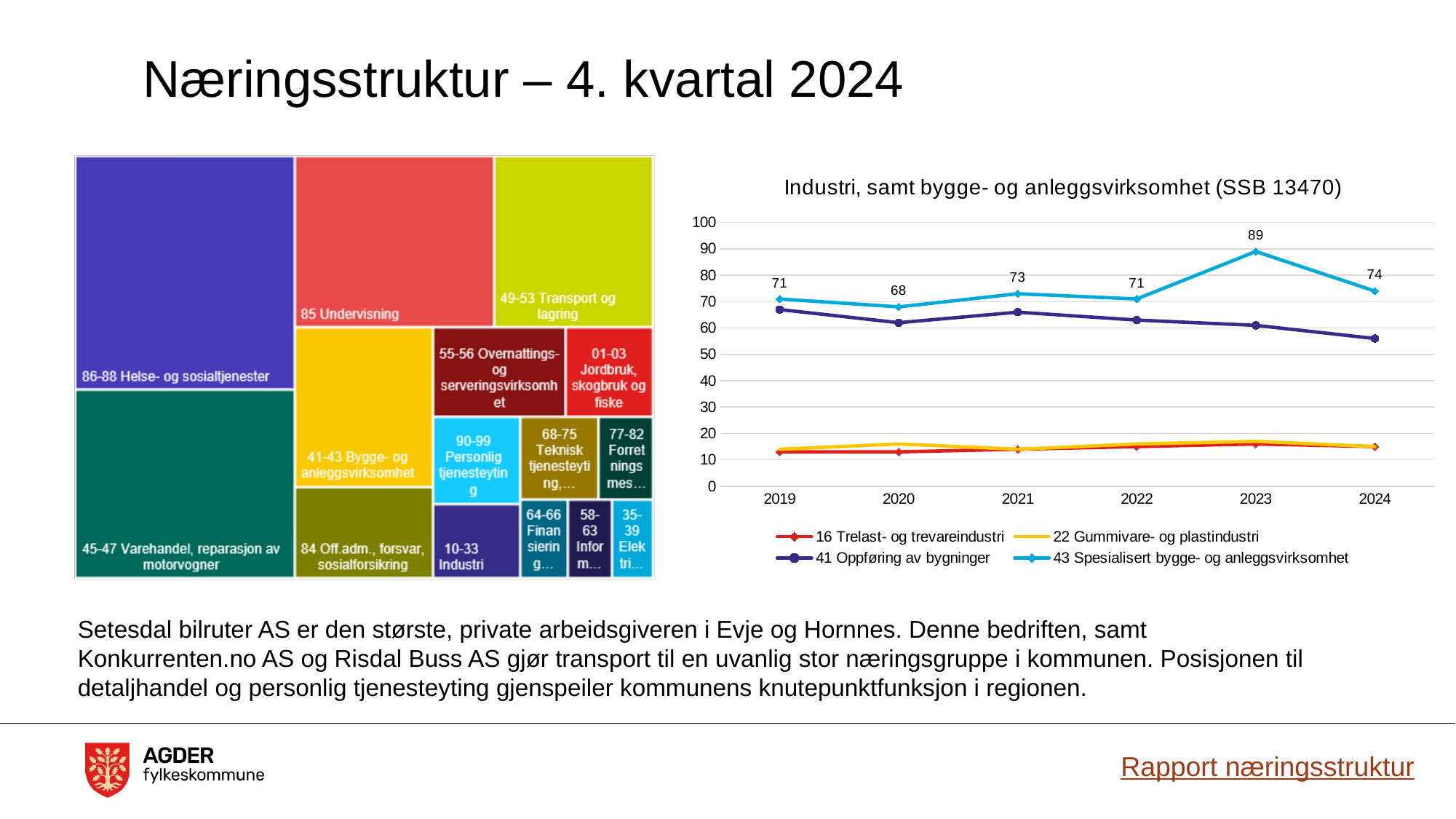
In the chart titled 'Industri, samt bygge- og anleggsvirksomhet (SSB 13470)', in which year is 43 Spesialisert bygge- og anleggsvirksomhet lowest? 2020 In the chart titled 'Industri, samt bygge- og anleggsvirksomhet (SSB 13470)', is the value for 41 Oppføring av bygninger in 2024 greater or less than 60? less In the chart titled 'Industri, samt bygge- og anleggsvirksomhet (SSB 13470)', how many years are shown on the x axis? 6 In the chart titled 'Industri, samt bygge- og anleggsvirksomhet (SSB 13470)', in which year is 43 Spesialisert bygge- og anleggsvirksomhet highest? 2023 In the chart titled 'Industri, samt bygge- og anleggsvirksomhet (SSB 13470)', which year has the larger value for 43 Spesialisert bygge- og anleggsvirksomhet, 2020 or 2021? 2021 In the chart titled 'Industri, samt bygge- og anleggsvirksomhet (SSB 13470)', is the value for 41 Oppføring av bygninger in 2019 greater or less than 60? greater In the chart titled 'Industri, samt bygge- og anleggsvirksomhet (SSB 13470)', by how much did 43 Spesialisert bygge- og anleggsvirksomhet fall from 2023 to 2024? 15 In the chart titled 'Industri, samt bygge- og anleggsvirksomhet (SSB 13470)', what is the value for 43 Spesialisert bygge- og anleggsvirksomhet in 2023? 89 In the chart titled 'Industri, samt bygge- og anleggsvirksomhet (SSB 13470)', what is the value for 43 Spesialisert bygge- og anleggsvirksomhet in 2019? 71 In the chart titled 'Industri, samt bygge- og anleggsvirksomhet (SSB 13470)', does the value for 41 Oppføring av bygninger rise or fall from 2019 to 2024? fall In the chart titled 'Industri, samt bygge- og anleggsvirksomhet (SSB 13470)', how many series does the legend list? 4 What kind of chart is the one titled 'Industri, samt bygge- og anleggsvirksomhet (SSB 13470)'? line chart